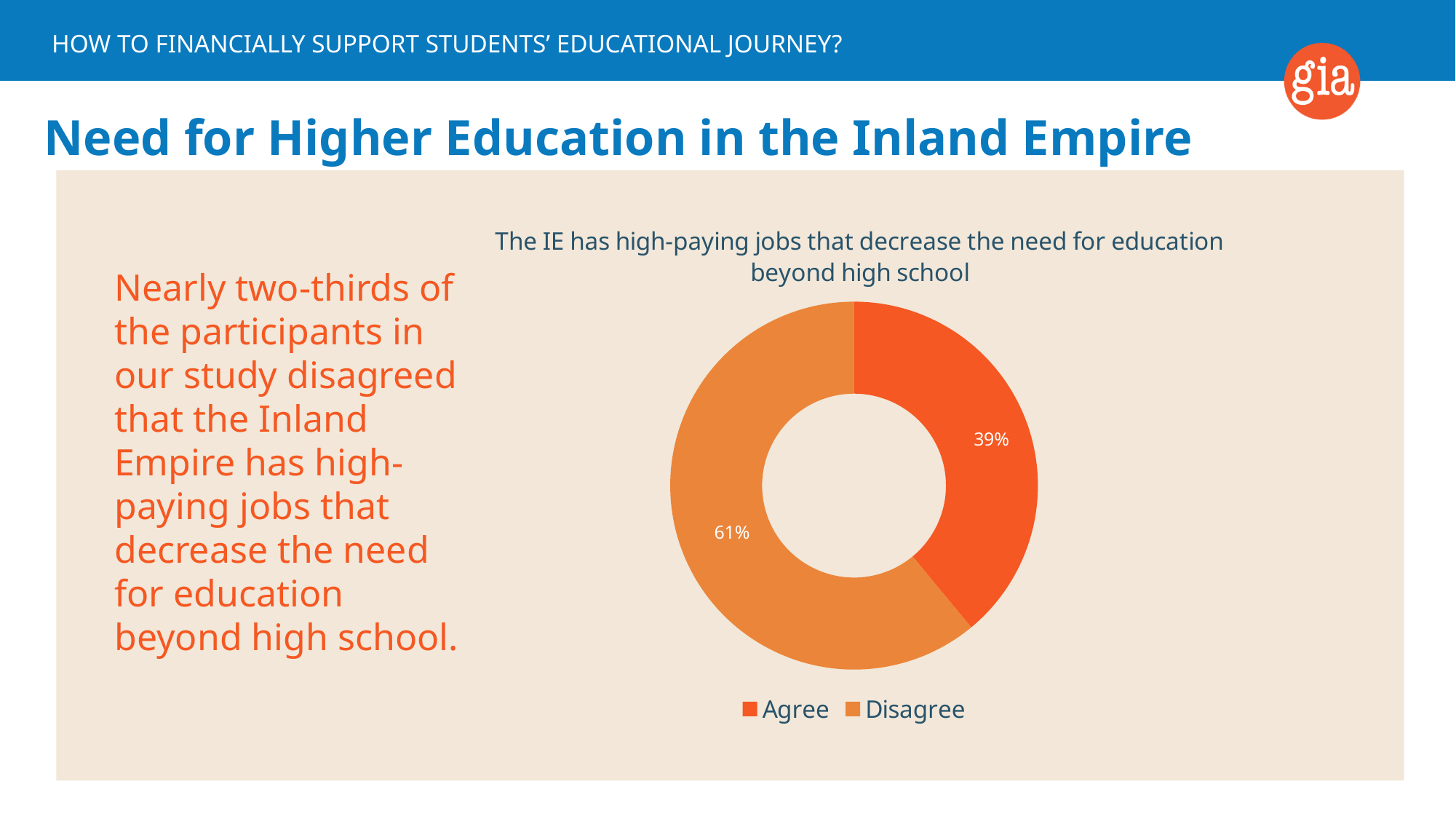
How many categories does the chart show? 2 What share of the chart does the Disagree slice represent? 61% What kind of chart is shown on the slide? Doughnut (pie) chart Which response has the smaller share of the chart? Agree What is the title of the chart? The IE has high-paying jobs that decrease the need for education beyond high school What are the two legend entries of the chart? Agree and Disagree What percentage of participants disagree that the IE has high-paying jobs that decrease the need for education beyond high school? 61% What is the difference in percentage points between the Disagree and Agree shares? 22 Which response has the larger share of the chart, Agree or Disagree? Disagree What percentage of participants agree that the IE has high-paying jobs that decrease the need for education beyond high school? 39% Is the Agree share larger or smaller than the Disagree share? smaller